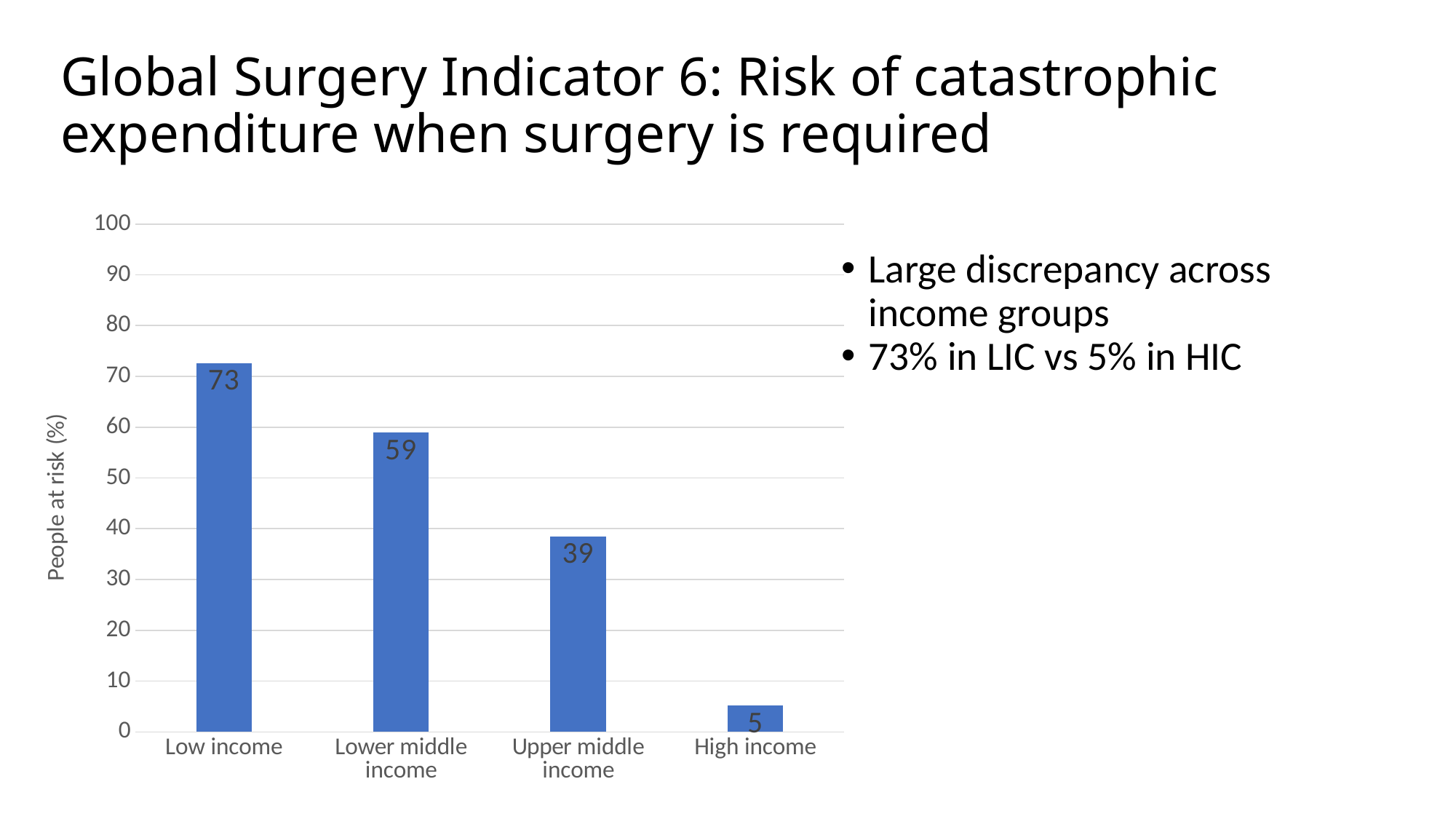
What is the difference between the values for Low income and High income? 68 Do the values rise or fall from left to right along the x axis? Fall What kind of chart is shown on the slide? Bar chart What is the value for Lower middle income? 59 Which income group has the lowest value? High income Which is larger, the value for Lower middle income or the value for Upper middle income? Lower middle income What is the value for Low income? 73 What is the difference between the values for Lower middle income and Upper middle income? 20 Which income group has the highest value? Low income What is the value for High income? 5 How many income groups are shown on the chart? 4 What is the value for Upper middle income? 39